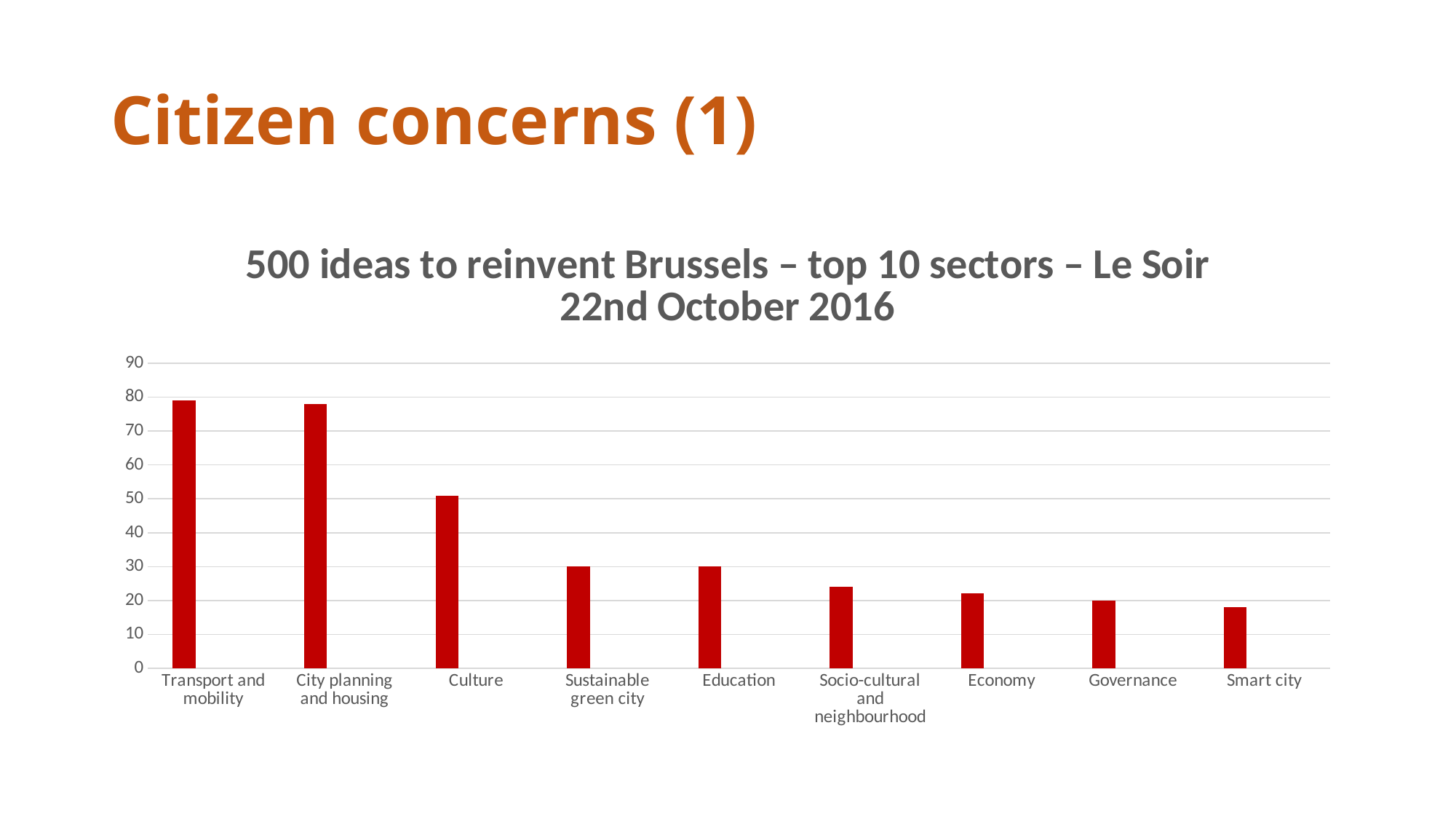
How many sectors are plotted on the chart? 9 Is the value for Smart city greater or less than 20? less Is the value for Culture greater or less than 60? less What is the title of the chart? 500 ideas to reinvent Brussels – top 10 sectors – Le Soir 22nd October 2016 Which is larger, the value for Socio-cultural and neighbourhood or the value for Governance? Socio-cultural and neighbourhood Do the values rise or fall moving from left to right along the x axis? fall What colour are the bars in the chart? red Is the value for Socio-cultural and neighbourhood greater or less than 20? greater Which sector has the lowest value? Smart city What kind of chart is shown on the slide? bar chart Which is larger, the value for Culture or the value for Education? Culture